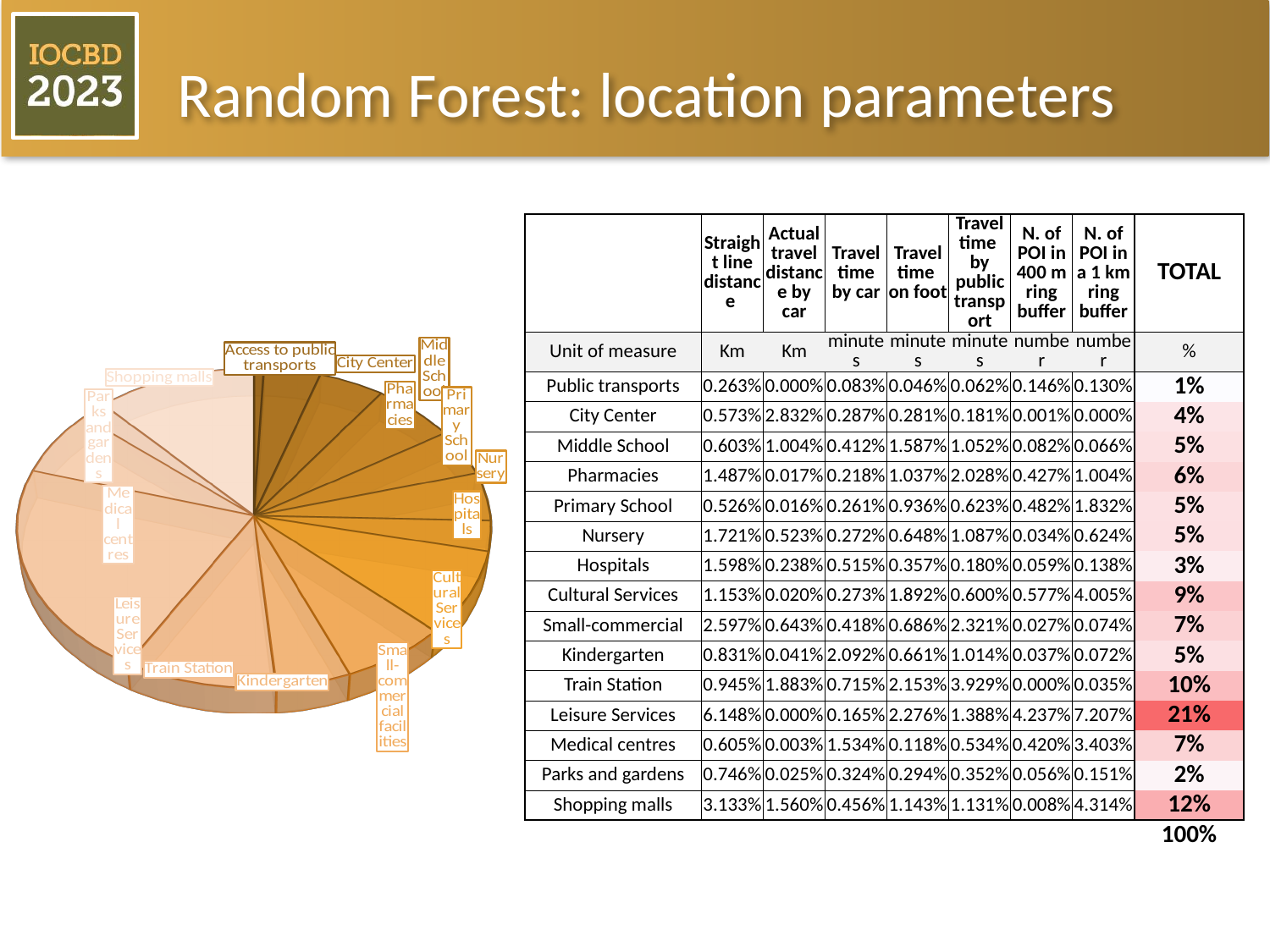
In the pie chart, which slice is larger: Cultural Services or Hospitals? Cultural Services In the pie chart, which slice is larger: Leisure Services or Train Station? Leisure Services In the pie chart, which slice is larger: Leisure Services or Access to public transports? Leisure Services How many slices does the pie chart have? 15 What kind of chart is shown on the left of the slide? pie chart Is the pie chart drawn in 2D or 3D? 3D What is the title of the slide containing the pie chart? Random Forest: location parameters Which category has the largest slice in the pie chart? Leisure Services